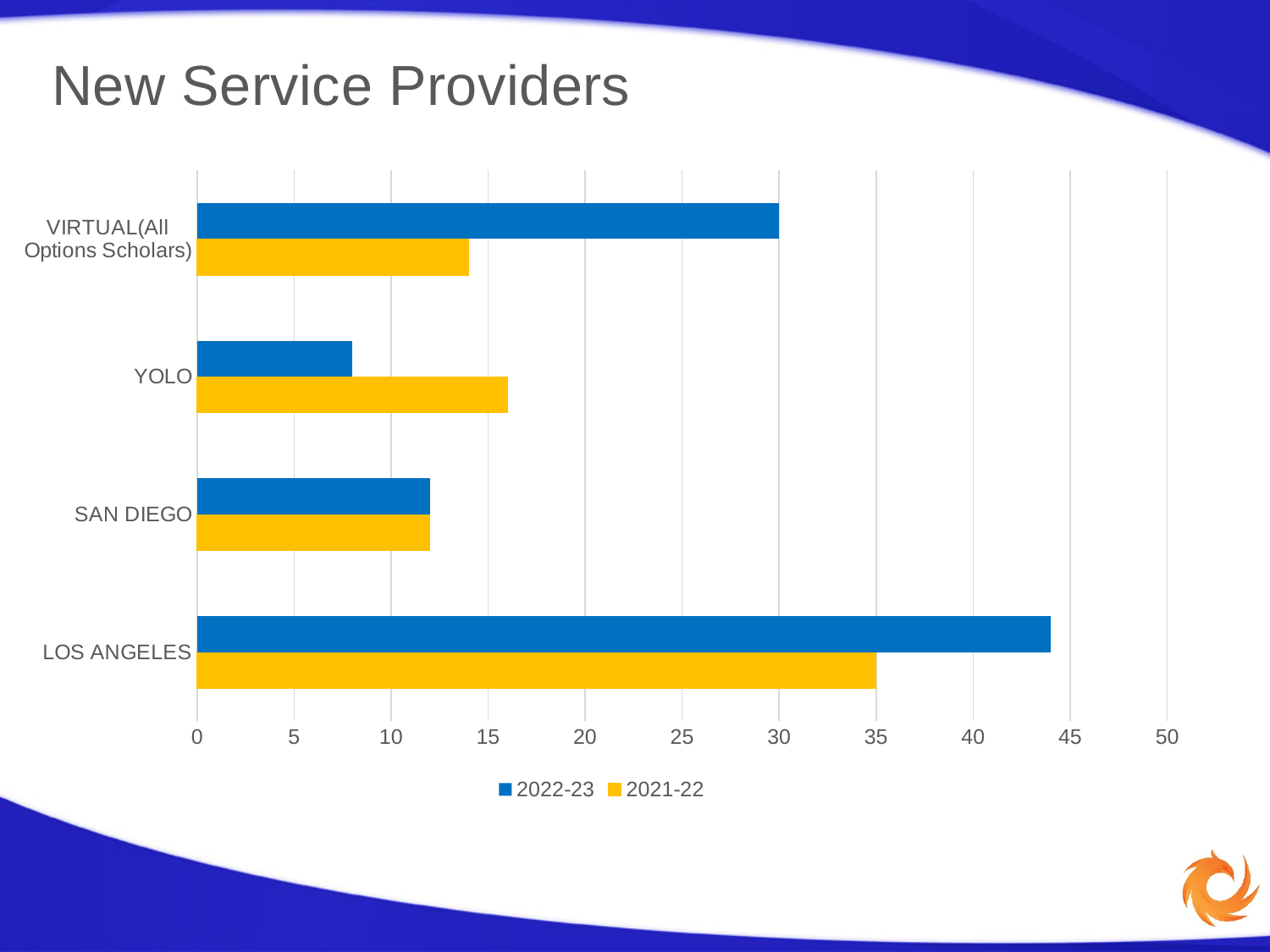
How many series does the legend list? 2 Which category has the highest 2021-22 value? LOS ANGELES Which category has the highest 2022-23 value? LOS ANGELES Is the 2022-23 value for LOS ANGELES greater or less than 40? greater What is the 2021-22 value for LOS ANGELES? 35 For VIRTUAL(All Options Scholars), which series has the larger value, 2022-23 or 2021-22? 2022-23 Is the 2022-23 value for YOLO greater or less than 10? less What kind of chart is shown on the slide? bar chart What is the 2022-23 value for VIRTUAL(All Options Scholars)? 30 Which category has the lowest 2022-23 value? YOLO What is the title of the chart? New Service Providers How many categories are shown on the chart? 4